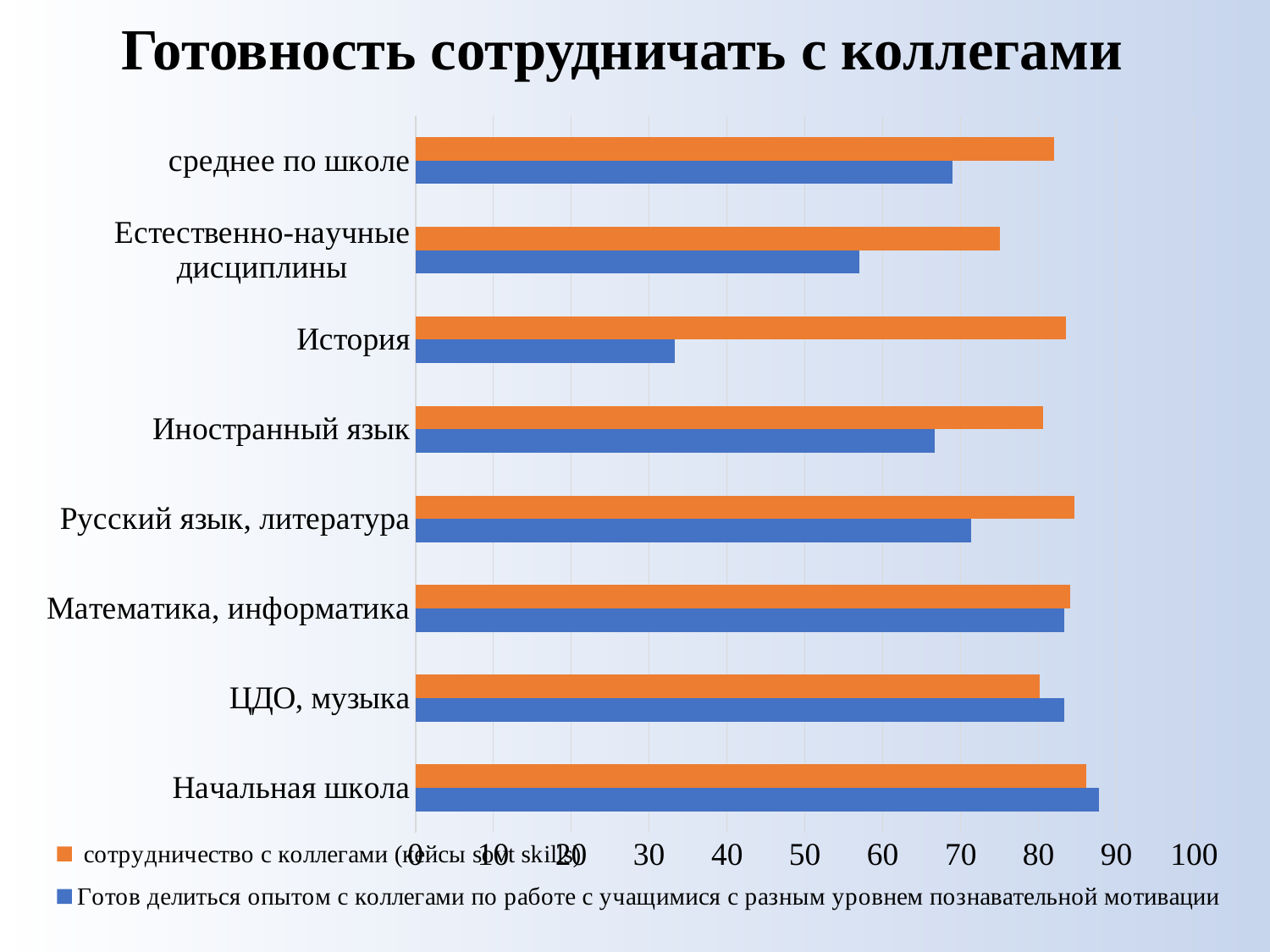
Which category has the lowest value for the series 'Готов делиться опытом с коллегами по работе с учащимися с разным уровнем познавательной мотивации'? История What is the title of the chart? Готовность сотрудничать с коллегами How many categories are shown on the vertical axis of the chart? 8 Is the value for Начальная школа in the series 'сотрудничество с коллегами (кейсы soft skills)' greater or less than 80? greater Is the value for История in the series 'Готов делиться опытом с коллегами по работе с учащимися с разным уровнем познавательной мотивации' greater or less than 40? less Which colour represents the series 'сотрудничество с коллегами (кейсы soft skills)'? orange Which category has the highest value for the series 'Готов делиться опытом с коллегами по работе с учащимися с разным уровнем познавательной мотивации'? Начальная школа Is the value for Естественно-научные дисциплины in the series 'Готов делиться опытом с коллегами по работе с учащимися с разным уровнем познавательной мотивации' greater or less than 60? less In the series 'Готов делиться опытом с коллегами по работе с учащимися с разным уровнем познавательной мотивации', which is larger: Русский язык, литература or Естественно-научные дисциплины? Русский язык, литература What kind of chart is shown on the slide? bar chart For История, which series has the larger value: 'сотрудничество с коллегами (кейсы soft skills)' or 'Готов делиться опытом с коллегами по работе с учащимися с разным уровнем познавательной мотивации'? сотрудничество с коллегами (кейсы soft skills) How many series does the legend list? 2